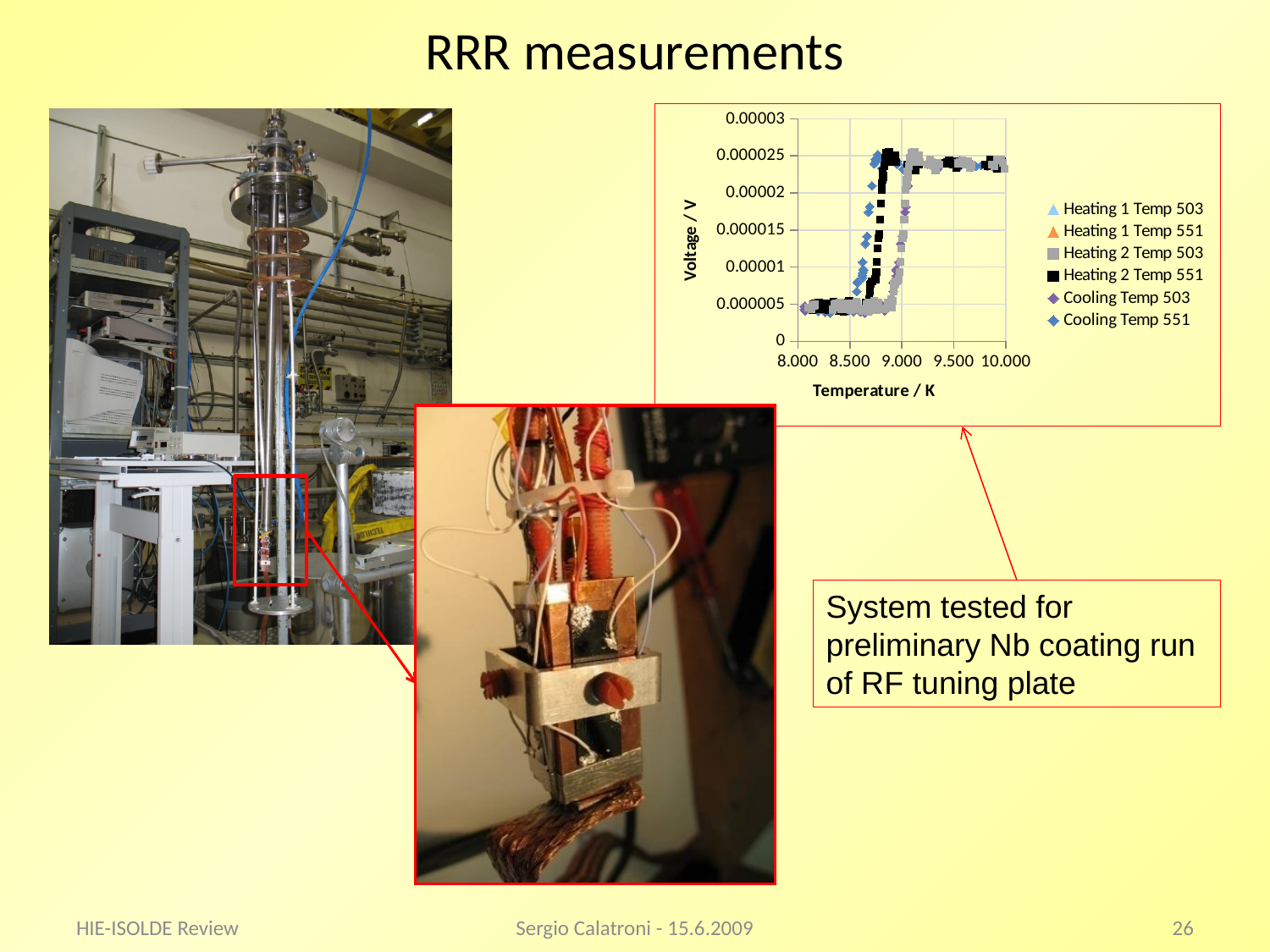
How many series does the legend of the chart list? 6 What is the title of the x axis of the chart? Temperature / K What is the title of the y axis of the chart? Voltage / V Is the voltage measured at 9.500 K greater or less than 0.000015? greater Is the voltage measured at 8.500 K greater or less than 0.00002? less Is the voltage measured at 8.000 K greater or less than 0.00001? less Does the voltage rise or fall as temperature increases from 8.000 K to 10.000 K? rise What kind of chart is shown on the slide? scatter chart Which is larger, the voltage at 10.000 K or the voltage at 8.000 K? the voltage at 10.000 K